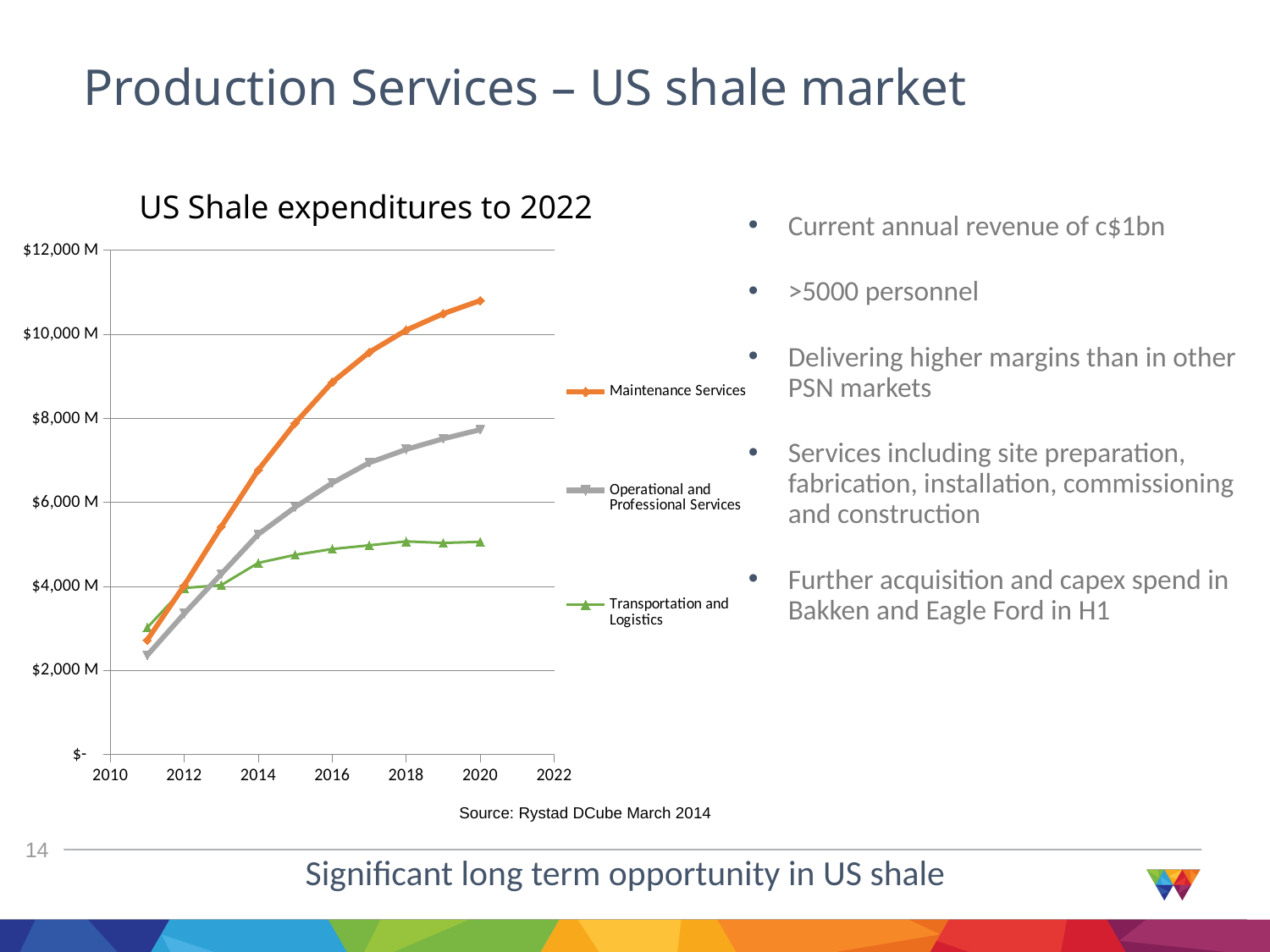
Which series has the lowest value in 2020? Transportation and Logistics What kind of chart is shown on the slide? Line chart Is the value for Transportation and Logistics in 2020 greater or less than $6,000 M? less What colour is the Maintenance Services line? Orange Is the value for Maintenance Services in 2020 greater or less than $10,000 M? greater What is the title of the chart? US Shale expenditures to 2022 Do the values for Maintenance Services rise or fall from 2011 to 2020? rise Which series has the highest value in 2020? Maintenance Services In 2011, which is larger: Transportation and Logistics or Operational and Professional Services? Transportation and Logistics Is the value for Operational and Professional Services in 2020 greater or less than $8,000 M? less How many series does the chart legend list? 3